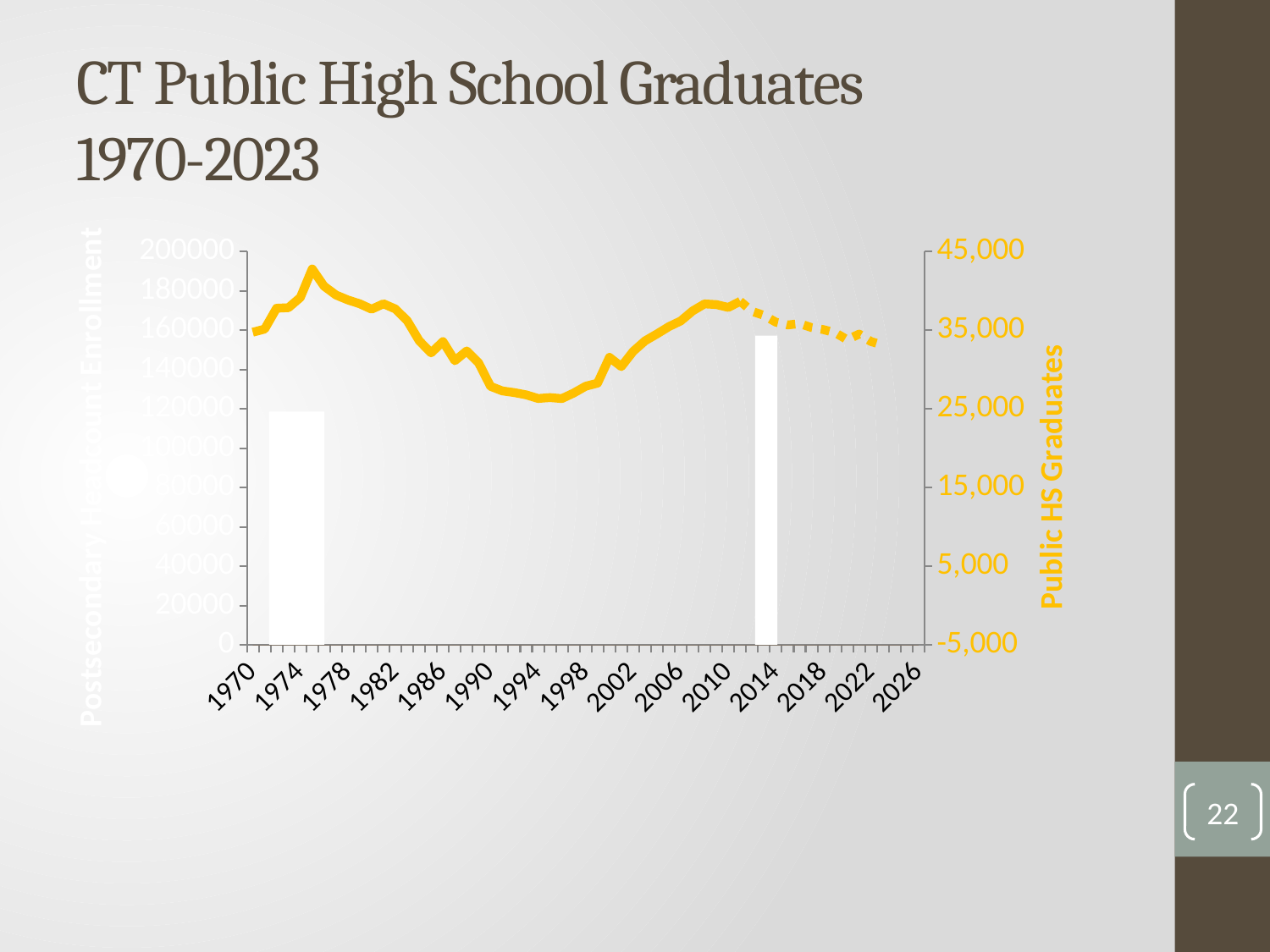
What is the title of the left vertical axis? Postsecondary Headcount Enrollment Does the Public HS Graduates line rise or fall between 1976 and 1994? fall Which of the two white bars is taller, the one around 1972 or the one around 2014? The one around 2014 Is the Public HS Graduates value for 2010 greater or less than 35,000? greater How many white bars are plotted on the chart? 2 In which year does the Public HS Graduates line reach its highest point? 1975 Is the Public HS Graduates value for 1994 greater or less than 35,000? less Is the second white bar (around 2014) greater or less than 140000 on the left axis? greater What is the title of the right vertical axis? Public HS Graduates What kind of chart is shown on the slide? A combination chart with a line and bars